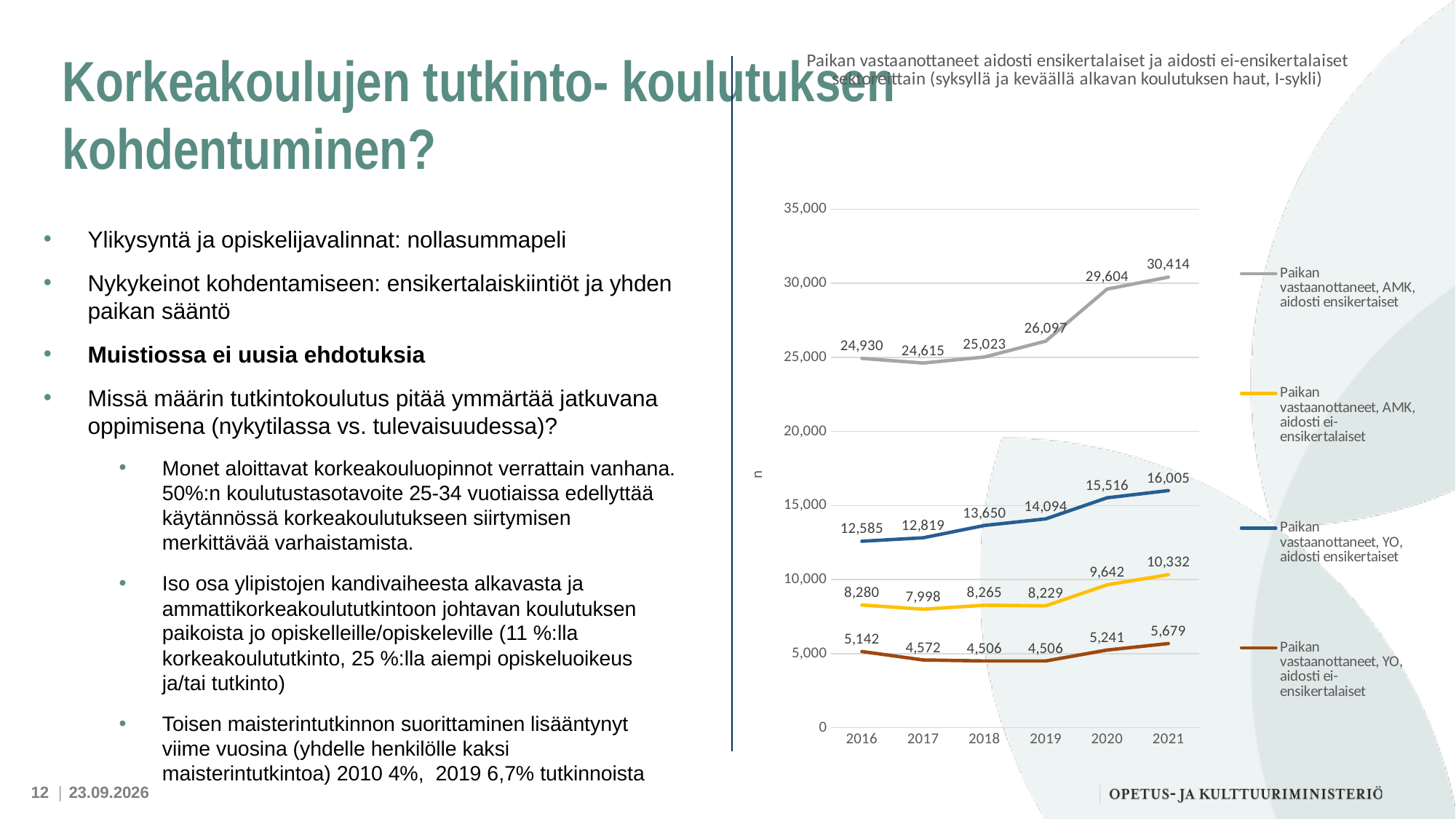
What kind of chart is shown on the slide? line chart How many years are shown on the x axis of the chart? 6 What is the value for 'Paikan vastaanottaneet, YO, aidosti ensikertalaiset' in 2018? 13,650 What is the difference between the 2021 and 2016 values for 'Paikan vastaanottaneet, AMK, aidosti ensikertalaiset'? 5,484 Which series is drawn in yellow on the chart? Paikan vastaanottaneet, AMK, aidosti ei-ensikertalaiset Which is larger in 2020: 'Paikan vastaanottaneet, AMK, aidosti ei-ensikertalaiset' or 'Paikan vastaanottaneet, YO, aidosti ei-ensikertalaiset'? Paikan vastaanottaneet, AMK, aidosti ei-ensikertalaiset How many series does the chart legend list? 4 What is the value for 'Paikan vastaanottaneet, YO, aidosti ei-ensikertalaiset' in 2017? 4,572 In which year is the value for 'Paikan vastaanottaneet, YO, aidosti ensikertalaiset' highest? 2021 In which year is the value for 'Paikan vastaanottaneet, AMK, aidosti ei-ensikertalaiset' lowest? 2017 Does the value for 'Paikan vastaanottaneet, YO, aidosti ensikertalaiset' rise or fall from 2016 to 2021? rise What is the value for 'Paikan vastaanottaneet, AMK, aidosti ensikertalaiset' in 2021? 30,414